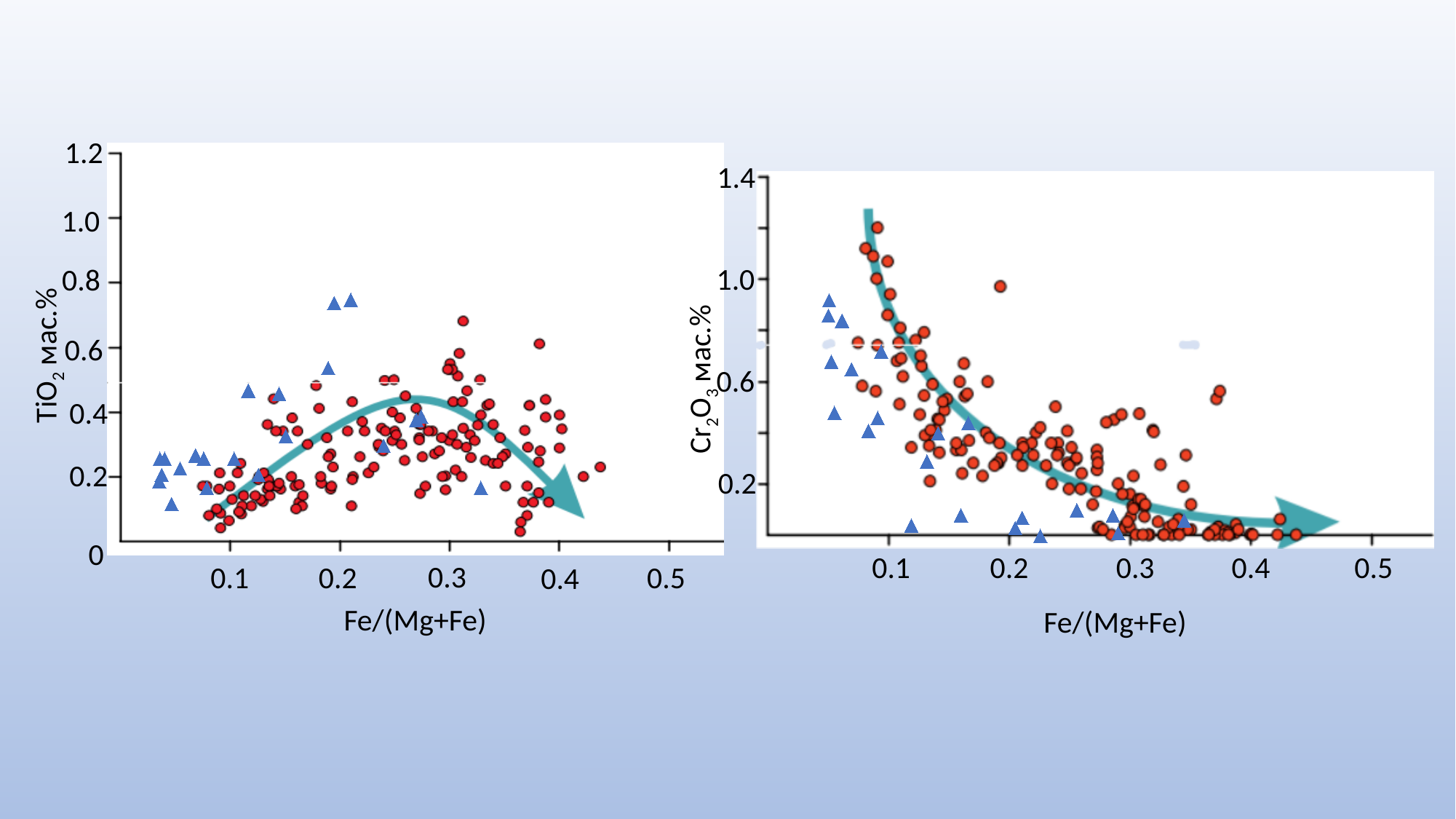
On the left chart (TiO2 мас.%), does the trend arrow first rise and then fall, or fall and then rise, as Fe/(Mg+Fe) increases? rise and then fall What is the label of the y axis on the right chart? Cr2O3 мас.% On the right chart, what is the highest value shown on the y axis? 1.4 What is the label of the x axis on the left chart? Fe/(Mg+Fe) On the left chart, what is the highest value shown on the y axis? 1.2 How many different marker shapes are plotted on each chart? 2 On the right chart (Cr2O3 мас.%), do the values generally rise or fall as Fe/(Mg+Fe) increases? fall What kind of chart is the left chart with the TiO2 y-axis? scatter plot On the right chart, is the highest plotted point greater or less than 1.0 on the Cr2O3 axis? greater On the left chart, is the highest plotted point greater or less than 1.0 on the TiO2 axis? less What kind of chart is the right chart with the Cr2O3 y-axis? scatter plot